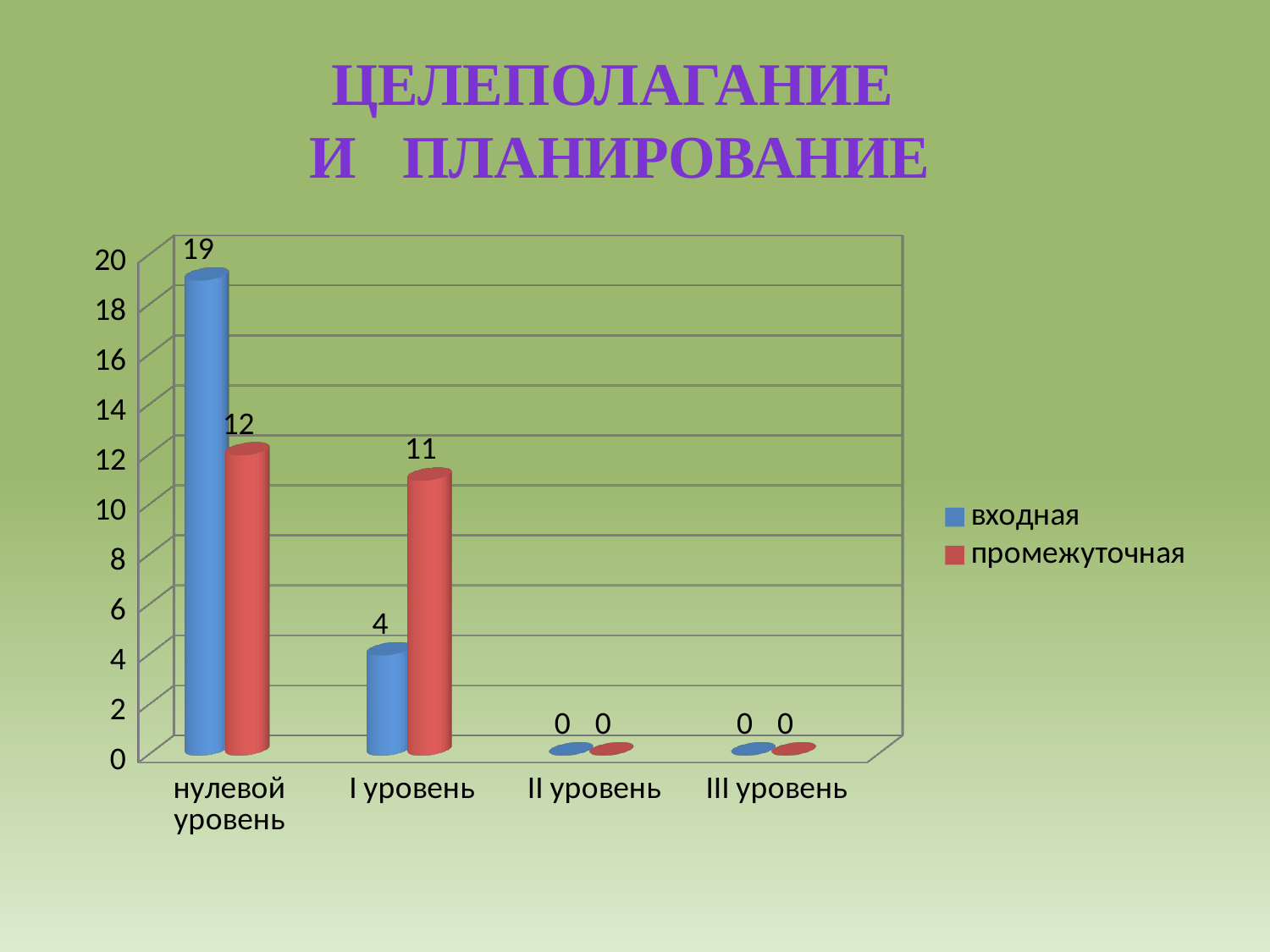
At I уровень, which series has the larger value, входная or промежуточная? промежуточная How many categories are shown on the x axis? 4 What is the value for входная at II уровень? 0 What kind of chart is shown on the slide? bar chart What is the value for входная at I уровень? 4 Which category has the highest value for промежуточная? нулевой уровень What is the difference between входная and промежуточная at нулевой уровень? 7 What is the value for промежуточная at нулевой уровень? 12 Which category has the highest value for входная? нулевой уровень What is the value for промежуточная at I уровень? 11 How many series does the legend list? 2 What is the value for входная at нулевой уровень? 19